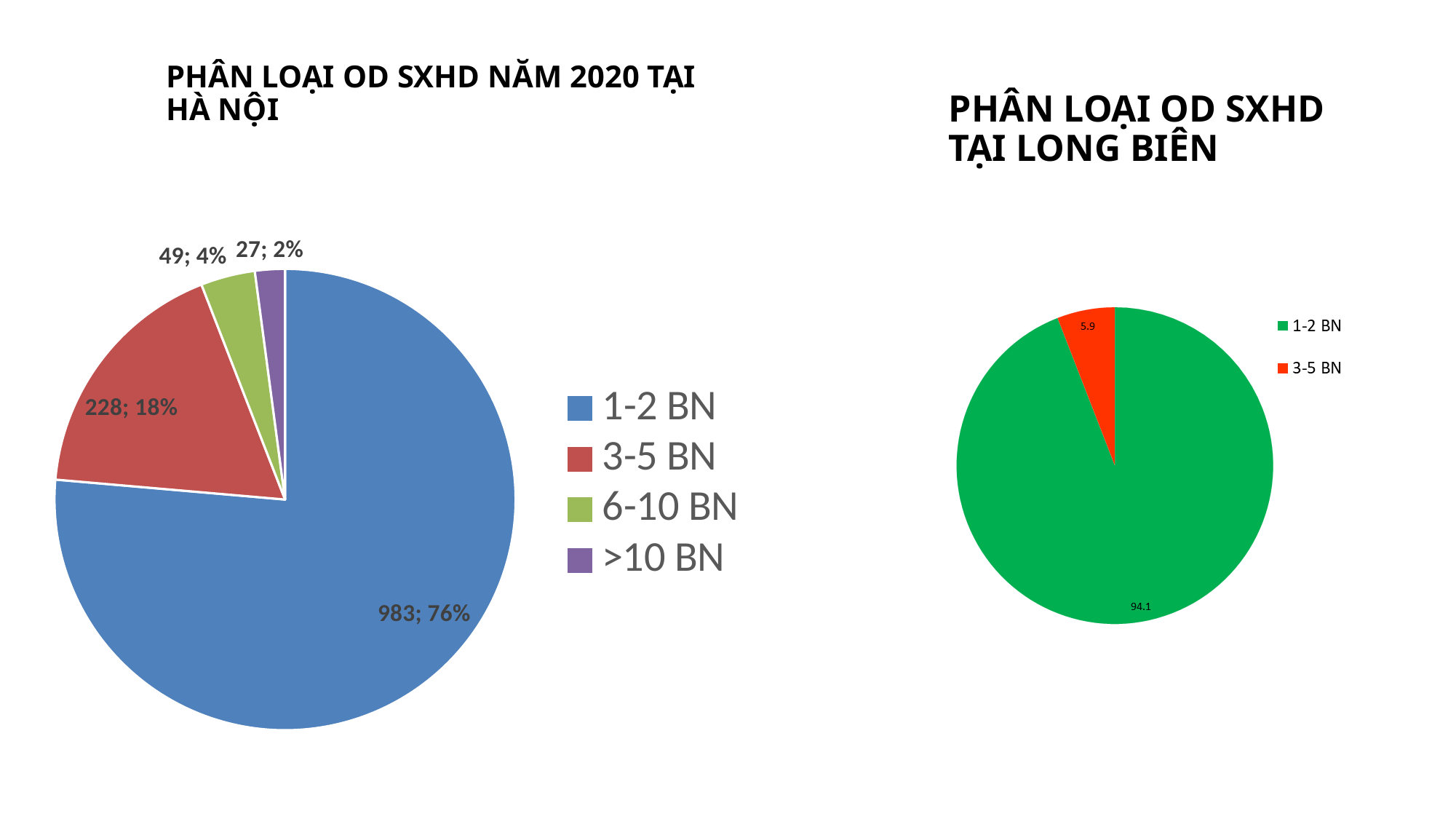
In the chart titled 'PHÂN LOẠI OD SXHD NĂM 2020 TẠI HÀ NỘI', which category has the largest slice? 1-2 BN In the chart titled 'PHÂN LOẠI OD SXHD TẠI LONG BIÊN', what value is shown for the 3-5 BN slice? 5.9 In the chart titled 'PHÂN LOẠI OD SXHD TẠI LONG BIÊN', what value is shown for the 1-2 BN slice? 94.1 In the chart titled 'PHÂN LOẠI OD SXHD NĂM 2020 TẠI HÀ NỘI', what percentage is shown for the 3-5 BN slice? 18% In the chart titled 'PHÂN LOẠI OD SXHD NĂM 2020 TẠI HÀ NỘI', what percentage is shown for the >10 BN slice? 2% In the chart titled 'PHÂN LOẠI OD SXHD NĂM 2020 TẠI HÀ NỘI', what is the count shown for the 6-10 BN slice? 49 In the chart titled 'PHÂN LOẠI OD SXHD TẠI LONG BIÊN', which is larger, the 1-2 BN slice or the 3-5 BN slice? 1-2 BN In the chart titled 'PHÂN LOẠI OD SXHD NĂM 2020 TẠI HÀ NỘI', how many categories does the legend list? 4 In the chart titled 'PHÂN LOẠI OD SXHD NĂM 2020 TẠI HÀ NỘI', what is the count shown for the 1-2 BN slice? 983 In the chart titled 'PHÂN LOẠI OD SXHD NĂM 2020 TẠI HÀ NỘI', what is the difference between the counts for 3-5 BN and 6-10 BN? 179 In the chart titled 'PHÂN LOẠI OD SXHD NĂM 2020 TẠI HÀ NỘI', which category has the smallest slice? >10 BN What type of chart is the one titled 'PHÂN LOẠI OD SXHD TẠI LONG BIÊN'? Pie chart